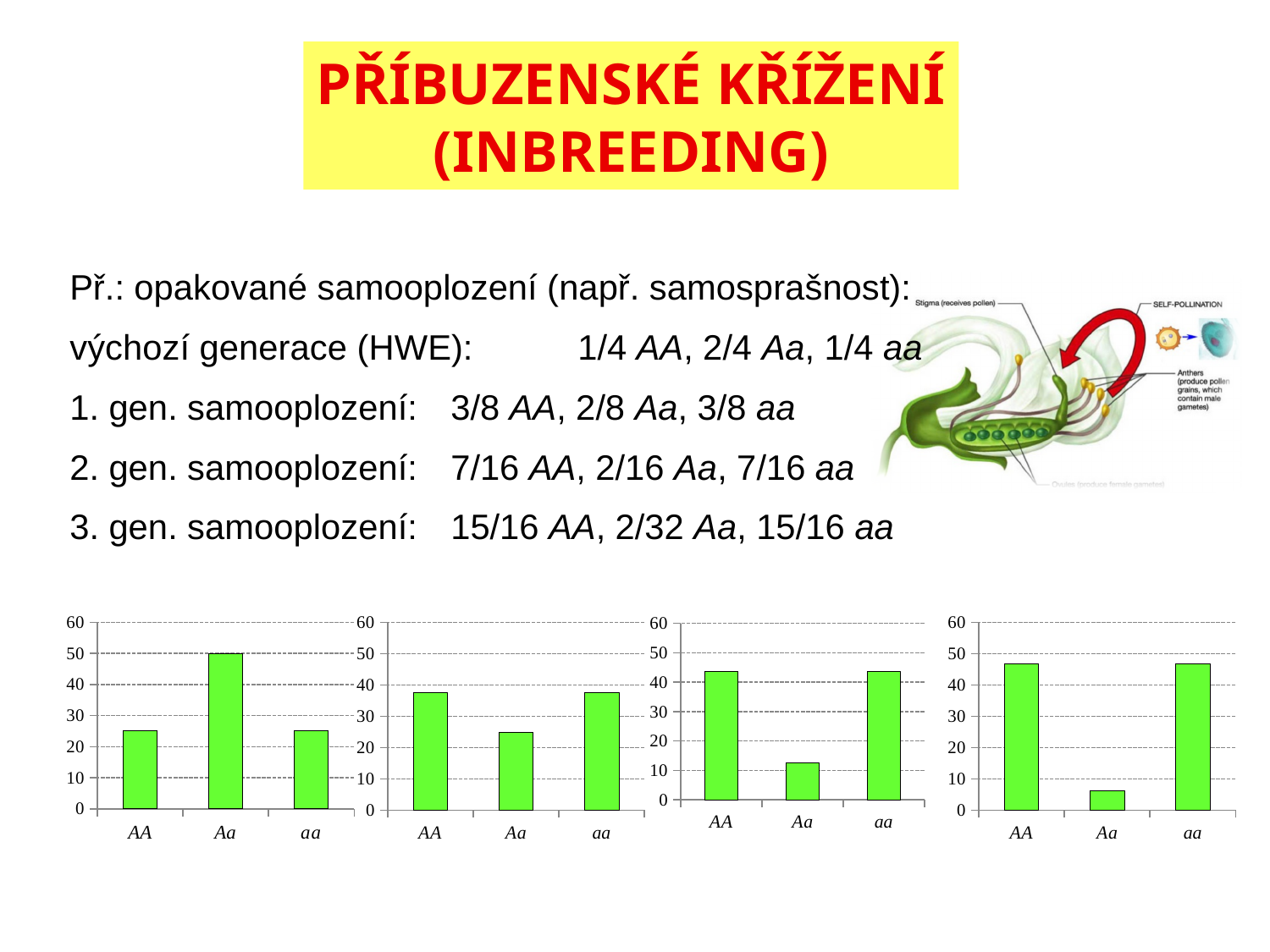
In the second chart from the left, which is larger, the value for AA or the value for Aa? AA What kind of chart is the leftmost chart at the bottom of the slide? bar chart In the third chart from the left, is the value for Aa greater or less than 20? less In the second chart from the left, which category has the lowest bar? Aa In the leftmost chart, what is the value for Aa? 50 In the leftmost chart, which category has the highest bar? Aa In the rightmost chart, is the value for AA greater or less than 40? greater In the second chart from the left, is the value for AA greater or less than 30? greater In the rightmost chart, which category has the lowest bar? Aa How many bar charts are shown along the bottom of the slide? 4 How many categories are plotted on the x axis of the leftmost chart? 3